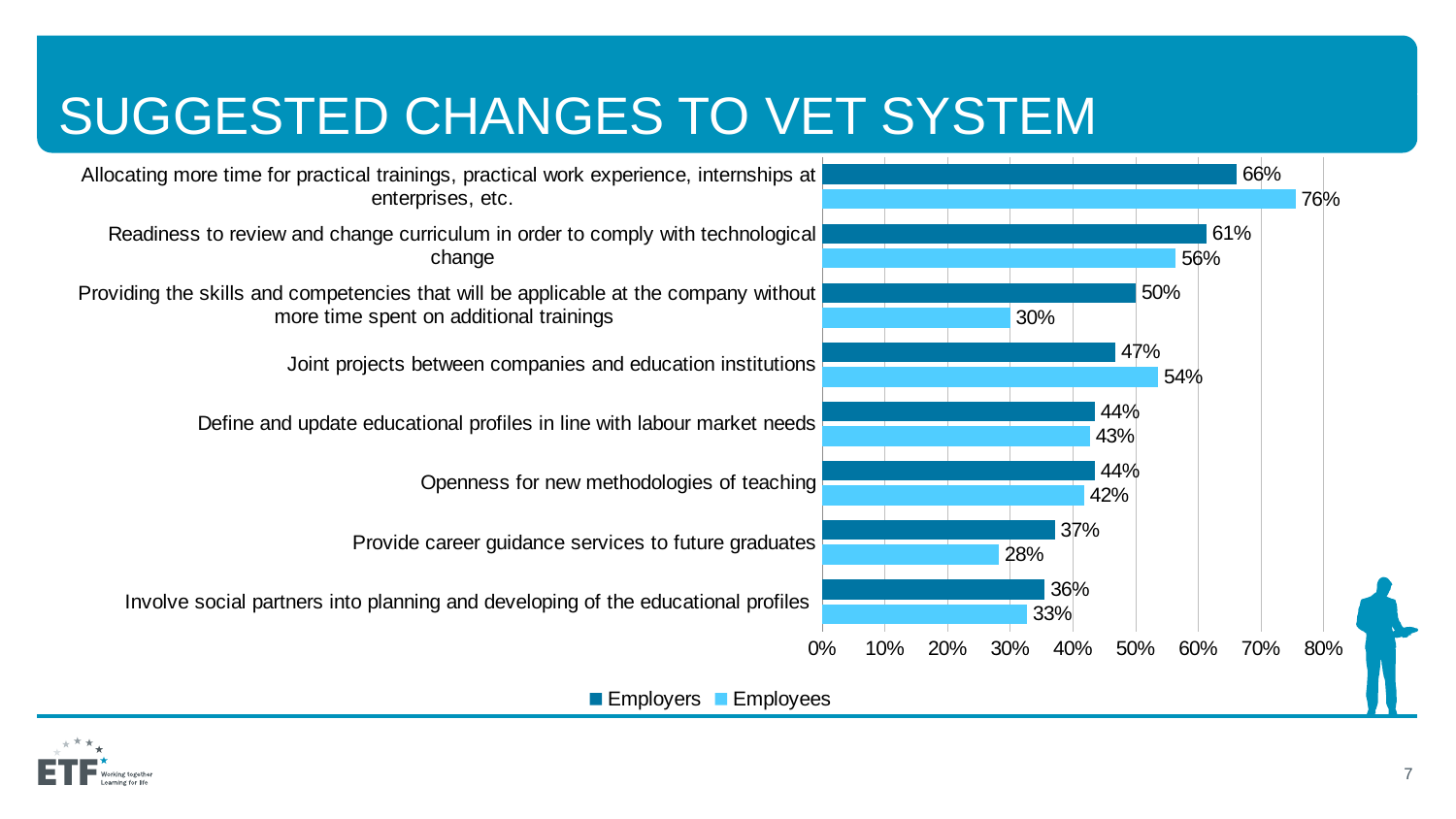
What is the title of the slide? SUGGESTED CHANGES TO VET SYSTEM Which category has the highest Employers value? Allocating more time for practical trainings, practical work experience, internships at enterprises, etc. Is the Employees value for 'Joint projects between companies and education institutions' greater or less than 50%? greater For 'Readiness to review and change curriculum in order to comply with technological change', which is larger: the Employers value or the Employees value? Employers How many series does the legend list? 2 Which category has the lowest Employees value? Provide career guidance services to future graduates How many categories are shown on the chart? 8 What is the Employees value for 'Allocating more time for practical trainings, practical work experience, internships at enterprises, etc.'? 76% What is the difference between the Employers and Employees values for 'Providing the skills and competencies that will be applicable at the company without more time spent on additional trainings'? 20% What kind of chart is shown on the slide? Bar chart What is the Employers value for 'Joint projects between companies and education institutions'? 47% What is the Employees value for 'Provide career guidance services to future graduates'? 28%